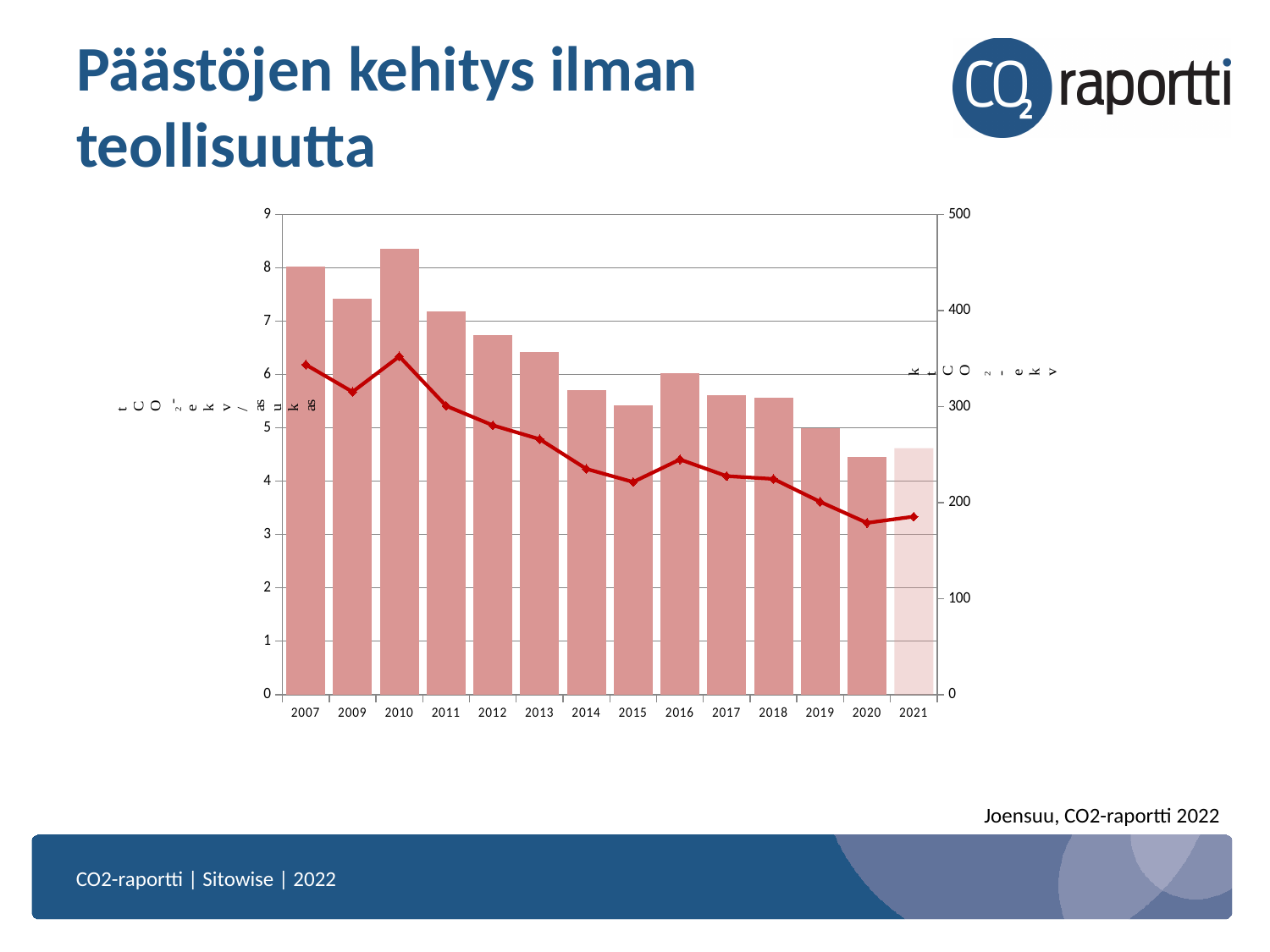
Which year has the shortest bar in the chart? 2020 What kind of chart is shown on the slide? A bar chart combined with a line chart Do the bar values generally rise or fall from 2007 to 2021? Fall Which year has the tallest bar in the chart? 2010 Which year has the taller bar, 2007 or 2009? 2007 Which year has the taller bar, 2015 or 2016? 2016 How many years are shown on the x axis of the chart? 14